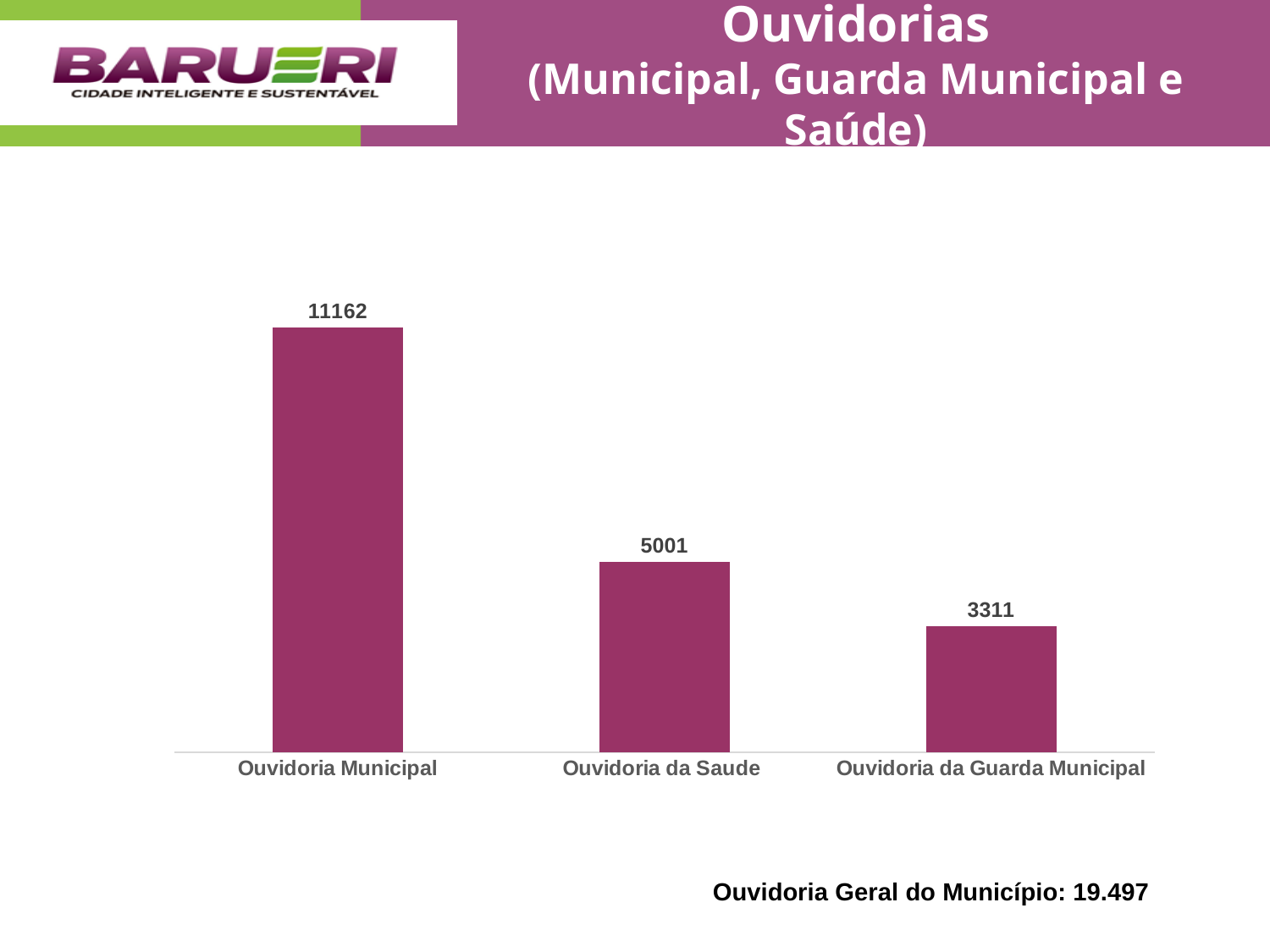
What is the difference between the values for Ouvidoria Municipal and Ouvidoria da Saude? 6161 Which is larger, the value for Ouvidoria da Saude or the value for Ouvidoria da Guarda Municipal? Ouvidoria da Saude How many categories are shown in the chart? 3 What is the difference between the values for Ouvidoria da Saude and Ouvidoria da Guarda Municipal? 1690 What is the value for Ouvidoria Municipal? 11162 What is the value for Ouvidoria da Saude? 5001 What kind of chart is shown on the slide? bar chart Do the values rise or fall from left to right across the categories? fall What total is given for Ouvidoria Geral do Município below the chart? 19.497 What is the value for Ouvidoria da Guarda Municipal? 3311 Which category has the highest value? Ouvidoria Municipal Which category has the lowest value? Ouvidoria da Guarda Municipal